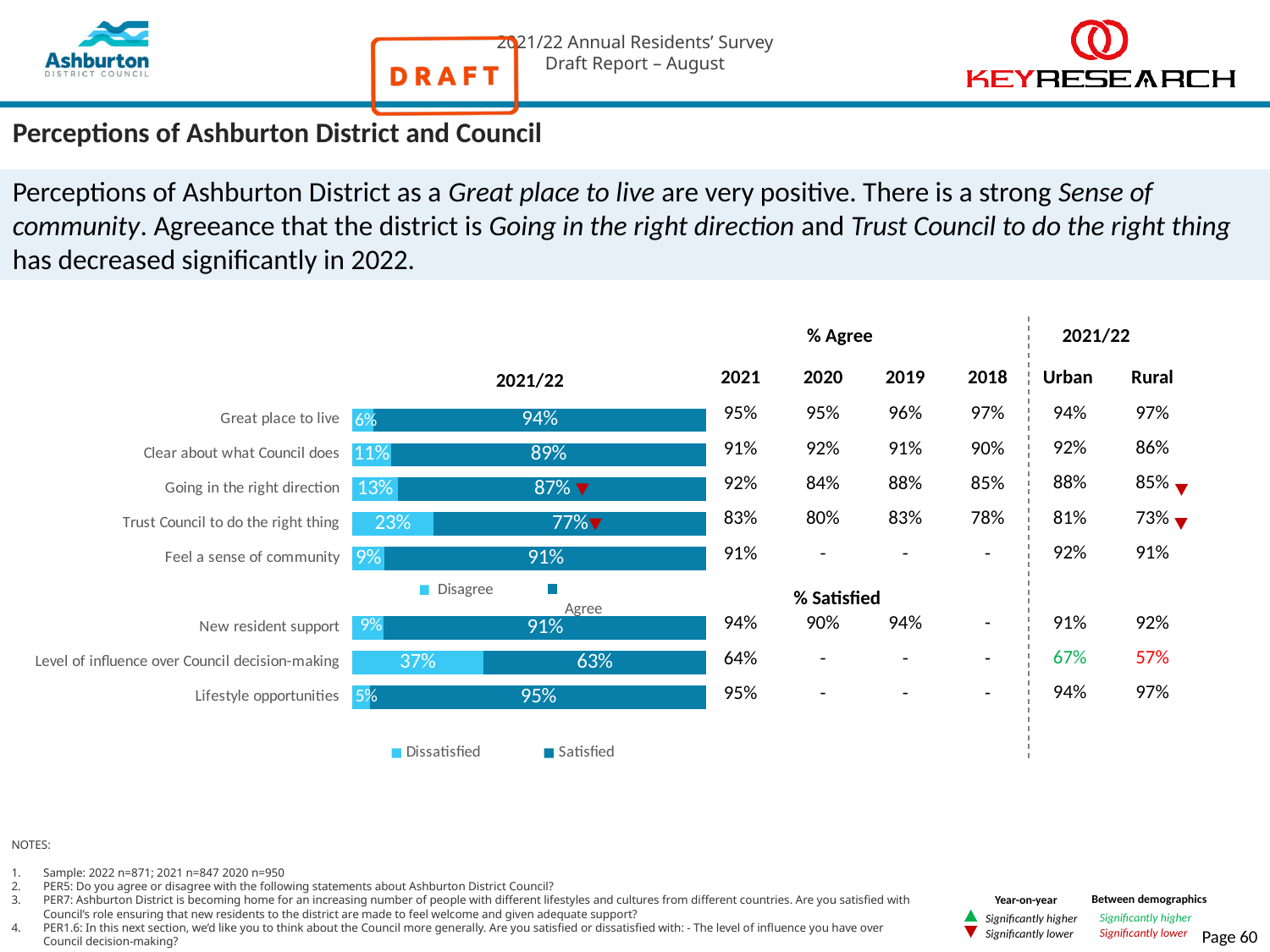
In the bottom chart (Dissatisfied/Satisfied), which category has the highest Dissatisfied value? Level of influence over Council decision-making In the top chart (Disagree/Agree), how many categories are plotted? 5 How many series does the legend of the bottom chart list? 2 In the top chart (Disagree/Agree), which category has the highest Agree value? Great place to live What type of chart is used on this slide? Stacked bar chart In the top chart (Disagree/Agree), which category has the lowest Agree value? Trust Council to do the right thing In the top chart (Disagree/Agree), what is the Agree value for Great place to live? 94% In the top chart (Disagree/Agree), what is the Disagree value for Trust Council to do the right thing? 23% In the bottom chart (Dissatisfied/Satisfied), what is the Dissatisfied value for Lifestyle opportunities? 5% In the top chart (Disagree/Agree), what is the difference between the Agree values for Clear about what Council does and Going in the right direction? 2% In the bottom chart (Dissatisfied/Satisfied), is the Satisfied value larger for New resident support or Lifestyle opportunities? Lifestyle opportunities In the bottom chart (Dissatisfied/Satisfied), what is the Satisfied value for Level of influence over Council decision-making? 63%